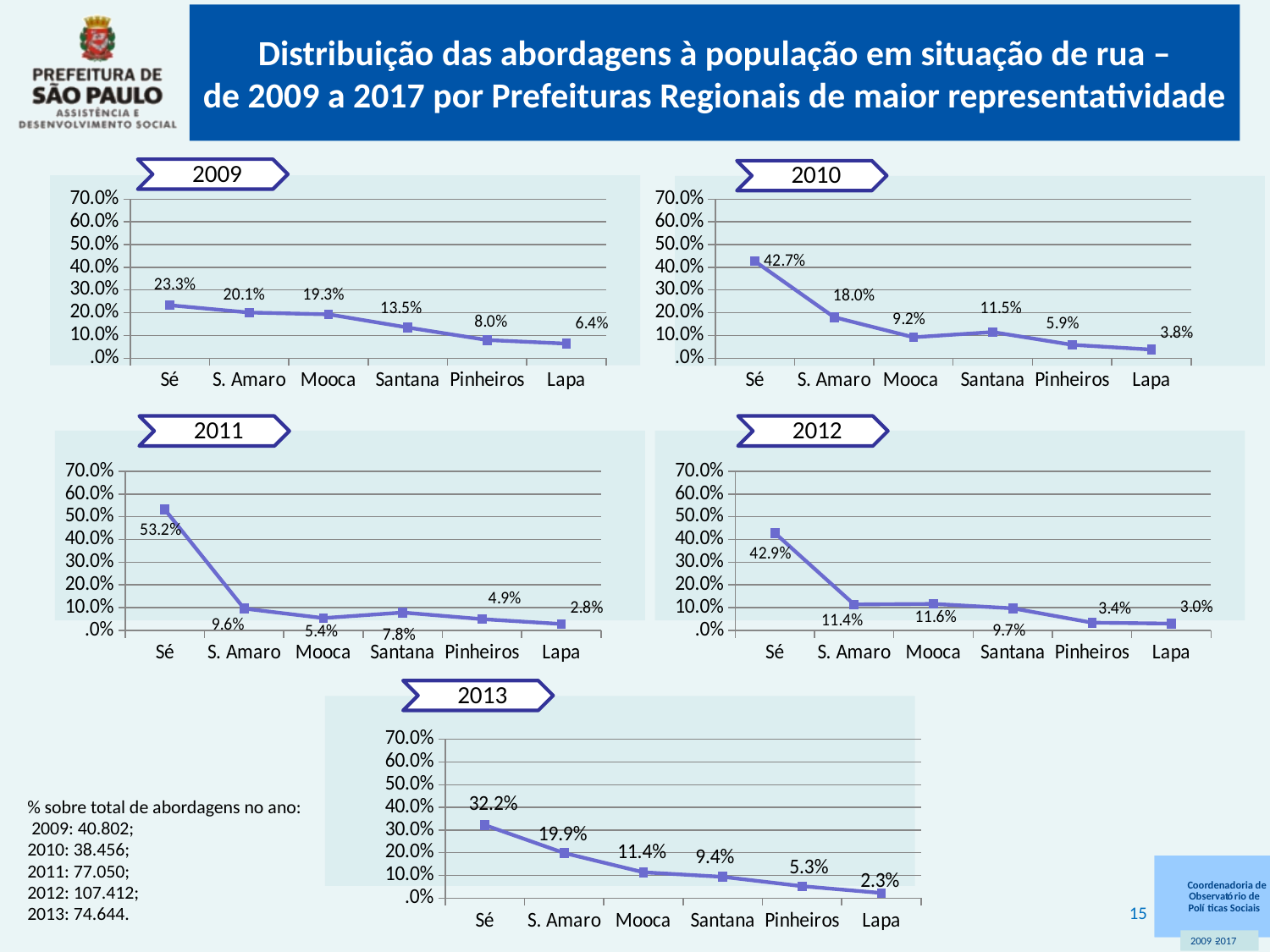
What kind of chart is the 2012 chart? line chart In the 2011 chart, is the value for Sé greater or less than 50.0%? greater In the 2013 chart, what is the difference between the values for Sé and S. Amaro? 12.3% In the 2013 chart, do the values rise or fall from Sé to Lapa? fall In the 2009 chart, what is the value for Sé? 23.3% In the 2010 chart, what is the value for Santana? 11.5% How many charts are shown on the slide? 5 In the 2012 chart, what is the value for Pinheiros? 3.4% How many categories are plotted in the 2013 chart? 6 In the 2011 chart, which category has the highest value? Sé In the 2010 chart, which is larger, the value for Mooca or the value for Santana? Santana In the 2012 chart, which category has the lowest value? Lapa